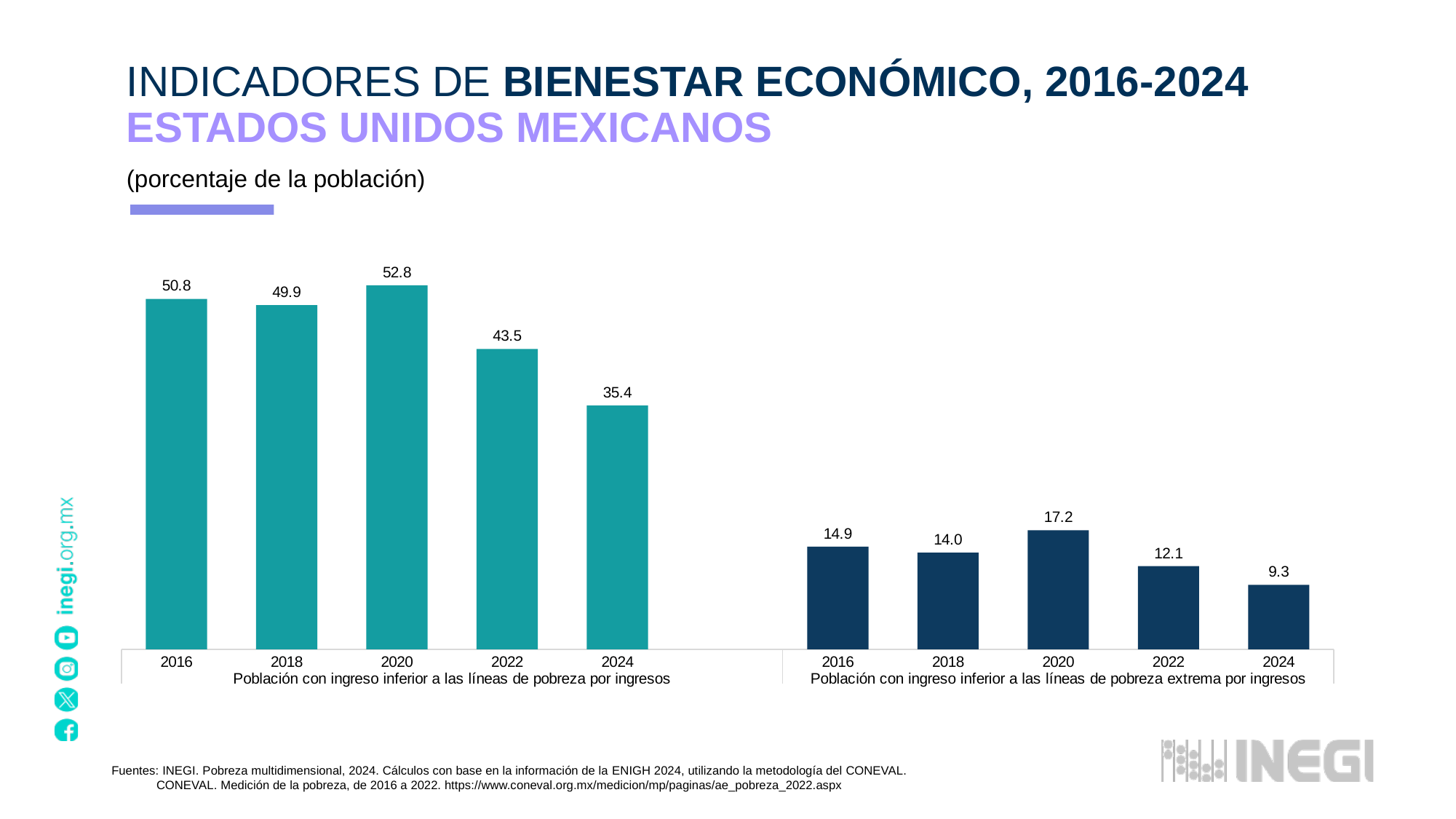
What is the value for 2020 in the group 'Población con ingreso inferior a las líneas de pobreza extrema por ingresos'? 17.2 Which year has the highest value in the group 'Población con ingreso inferior a las líneas de pobreza por ingresos'? 2020 What is the difference between the 2016 and 2018 values in the group 'Población con ingreso inferior a las líneas de pobreza extrema por ingresos'? 0.9 What is the value for 2018 in the group 'Población con ingreso inferior a las líneas de pobreza por ingresos'? 49.9 What kind of chart is shown on the slide? Bar chart What unit is stated in the subtitle for the values on the chart? porcentaje de la población From 2020 to 2024, do the values in the group 'Población con ingreso inferior a las líneas de pobreza extrema por ingresos' rise or fall? Fall Which year has the lowest value in the group 'Población con ingreso inferior a las líneas de pobreza extrema por ingresos'? 2024 What is the difference between the 2020 and 2024 values in the group 'Población con ingreso inferior a las líneas de pobreza por ingresos'? 17.4 Which is larger: the 2016 value for 'pobreza por ingresos' or the 2016 value for 'pobreza extrema por ingresos'? pobreza por ingresos (50.8) How many years are shown in each group of bars? 5 What is the value for 2024 in the group 'Población con ingreso inferior a las líneas de pobreza por ingresos'? 35.4